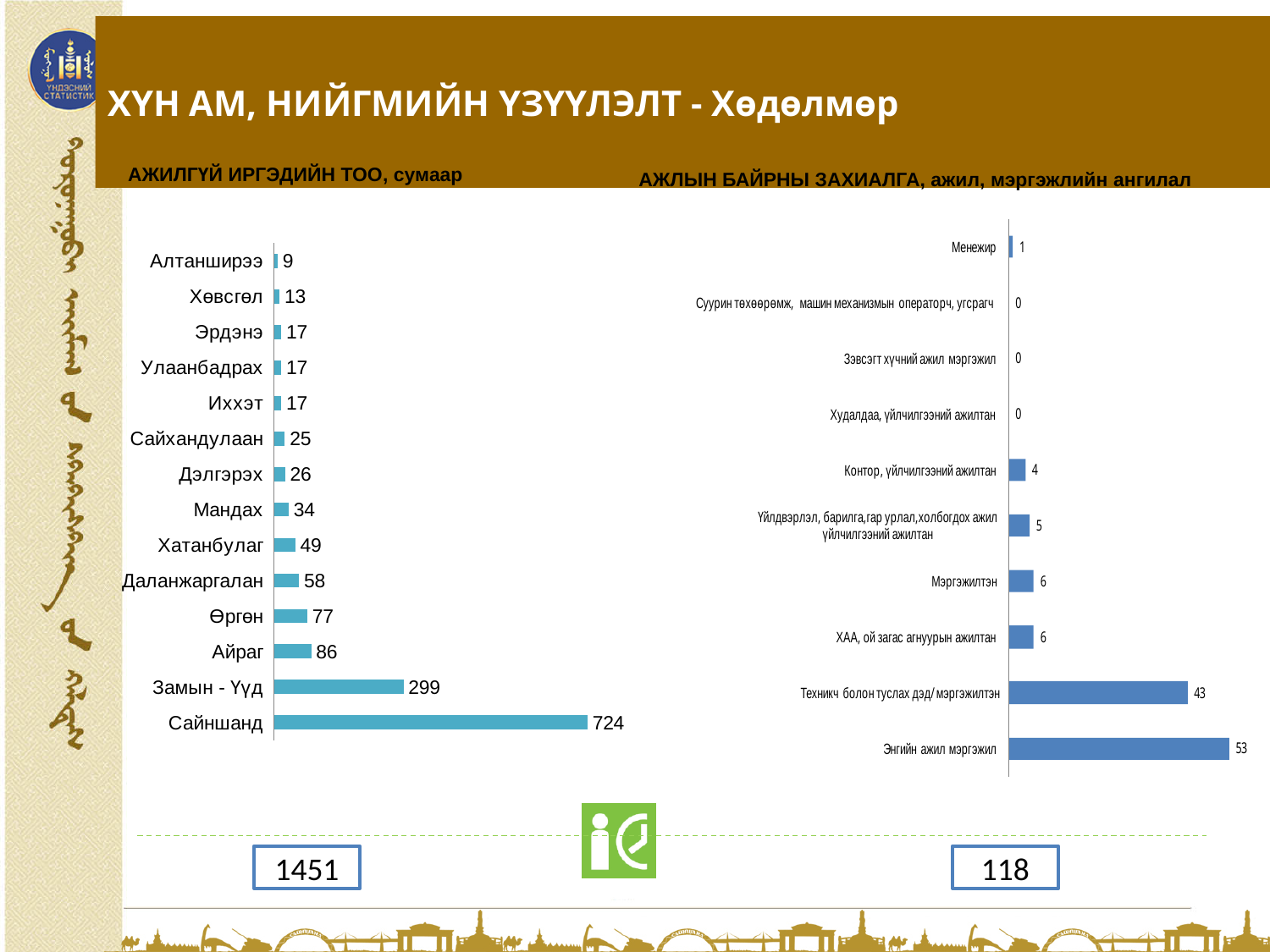
How many categories are shown in the chart titled 'АЖИЛГҮЙ ИРГЭДИЙН ТОО, сумаар'? 14 In the chart titled 'АЖИЛГҮЙ ИРГЭДИЙН ТОО, сумаар', what is the value for Хатанбулаг? 49 In the chart titled 'АЖИЛГҮЙ ИРГЭДИЙН ТОО, сумаар', what is the difference between the values for Сайншанд and Замын - Үүд? 425 How many categories are shown in the chart titled 'АЖЛЫН БАЙРНЫ ЗАХИАЛГА, ажил, мэргэжлийн ангилал'? 10 In the chart titled 'АЖЛЫН БАЙРНЫ ЗАХИАЛГА, ажил, мэргэжлийн ангилал', what is the difference between the values for Энгийн ажил мэргэжил and Техникч болон туслах дэд/ мэргэжилтэн? 10 In the chart titled 'АЖЛЫН БАЙРНЫ ЗАХИАЛГА, ажил, мэргэжлийн ангилал', which category has the highest value? Энгийн ажил мэргэжил What type of chart is the chart titled 'АЖИЛГҮЙ ИРГЭДИЙН ТОО, сумаар'? Bar chart In the chart titled 'АЖИЛГҮЙ ИРГЭДИЙН ТОО, сумаар', which is larger, the value for Өргөн or the value for Айраг? Айраг In the chart titled 'АЖИЛГҮЙ ИРГЭДИЙН ТОО, сумаар', what is the value for Сайншанд? 724 In the chart titled 'АЖИЛГҮЙ ИРГЭДИЙН ТОО, сумаар', which category has the lowest value? Алтанширээ In the chart titled 'АЖЛЫН БАЙРНЫ ЗАХИАЛГА, ажил, мэргэжлийн ангилал', what is the value for Техникч болон туслах дэд/ мэргэжилтэн? 43 In the chart titled 'АЖЛЫН БАЙРНЫ ЗАХИАЛГА, ажил, мэргэжлийн ангилал', what is the value for Менежир? 1